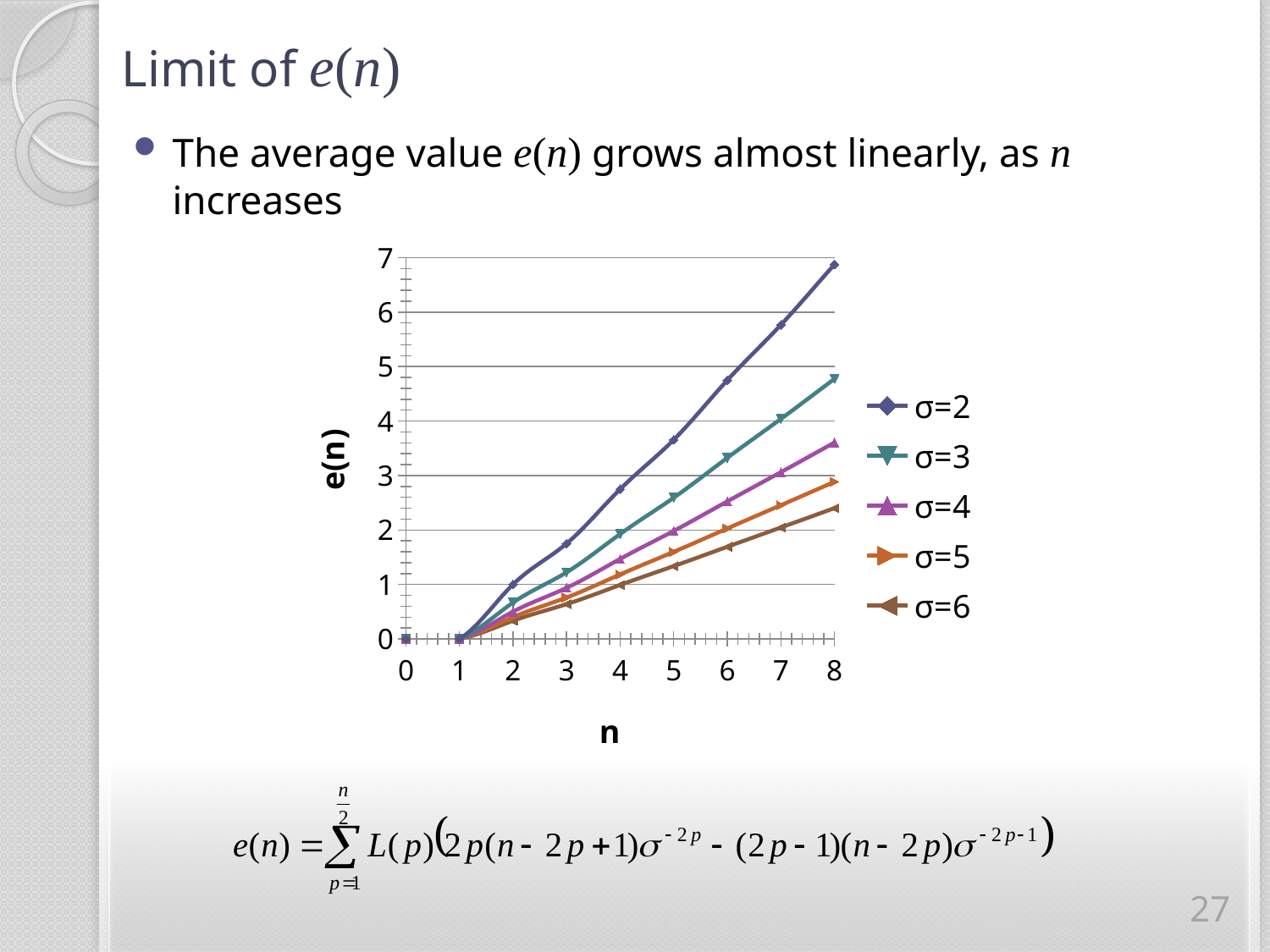
Is the value for σ=3 at n=8 greater or less than 4? greater At n=8, which is larger, the value for σ=4 or the value for σ=5? σ=4 Do the values of the σ=2 series rise or fall as n increases? rise Is the value for σ=6 at n=8 greater or less than 3? less What kind of chart is shown on the slide? line chart Is the value for σ=2 at n=8 greater or less than 6? greater Which series has the highest value at n=8? σ=2 Which series has the lowest value at n=8? σ=6 What is the value of the σ=2 series at n=1? 0 What is the label of the vertical axis? e(n) How many series does the legend list? 5 What is the label of the horizontal axis? n